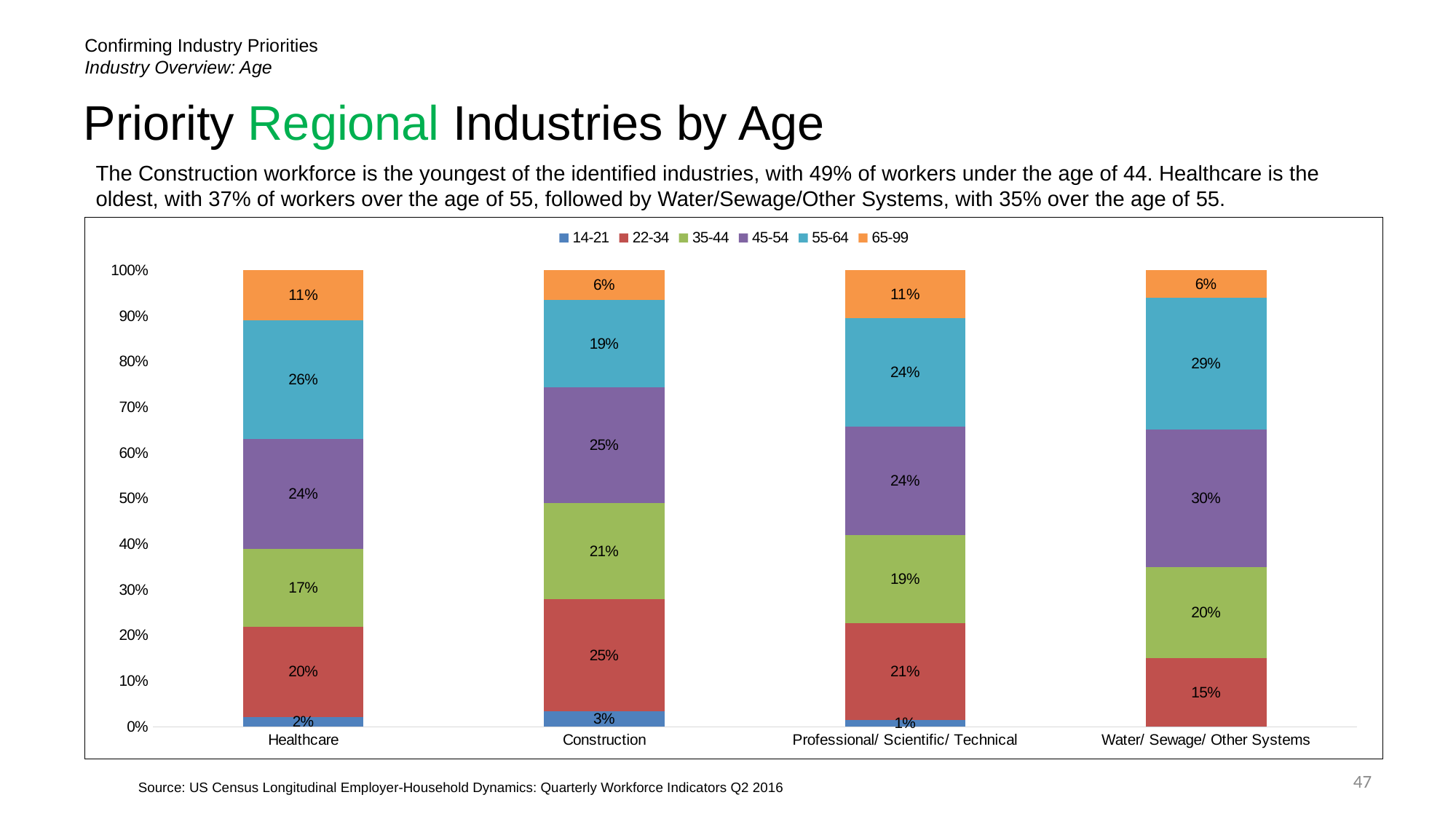
Which is larger: the 35-44 share for Construction or for Healthcare? Construction How many age groups does the legend list? 6 What percentage of the Professional/ Scientific/ Technical workforce is aged 14-21? 1% Which industry has the highest share of workers aged 65-99? Healthcare and Professional/ Scientific/ Technical (both 11%) What percentage of the Healthcare workforce is aged 55-64? 26% How many industries are shown on the x axis of the chart? 4 Which industry has the lowest share of workers aged 22-34? Water/ Sewage/ Other Systems What is the difference between the 55-64 share for Water/ Sewage/ Other Systems and for Construction? 10 percentage points What kind of chart is shown on the slide? Stacked bar chart What percentage of the Construction workforce is aged 22-34? 25% What colour represents the 45-54 age group in the chart? Purple What percentage of the Water/ Sewage/ Other Systems workforce is aged 45-54? 30%